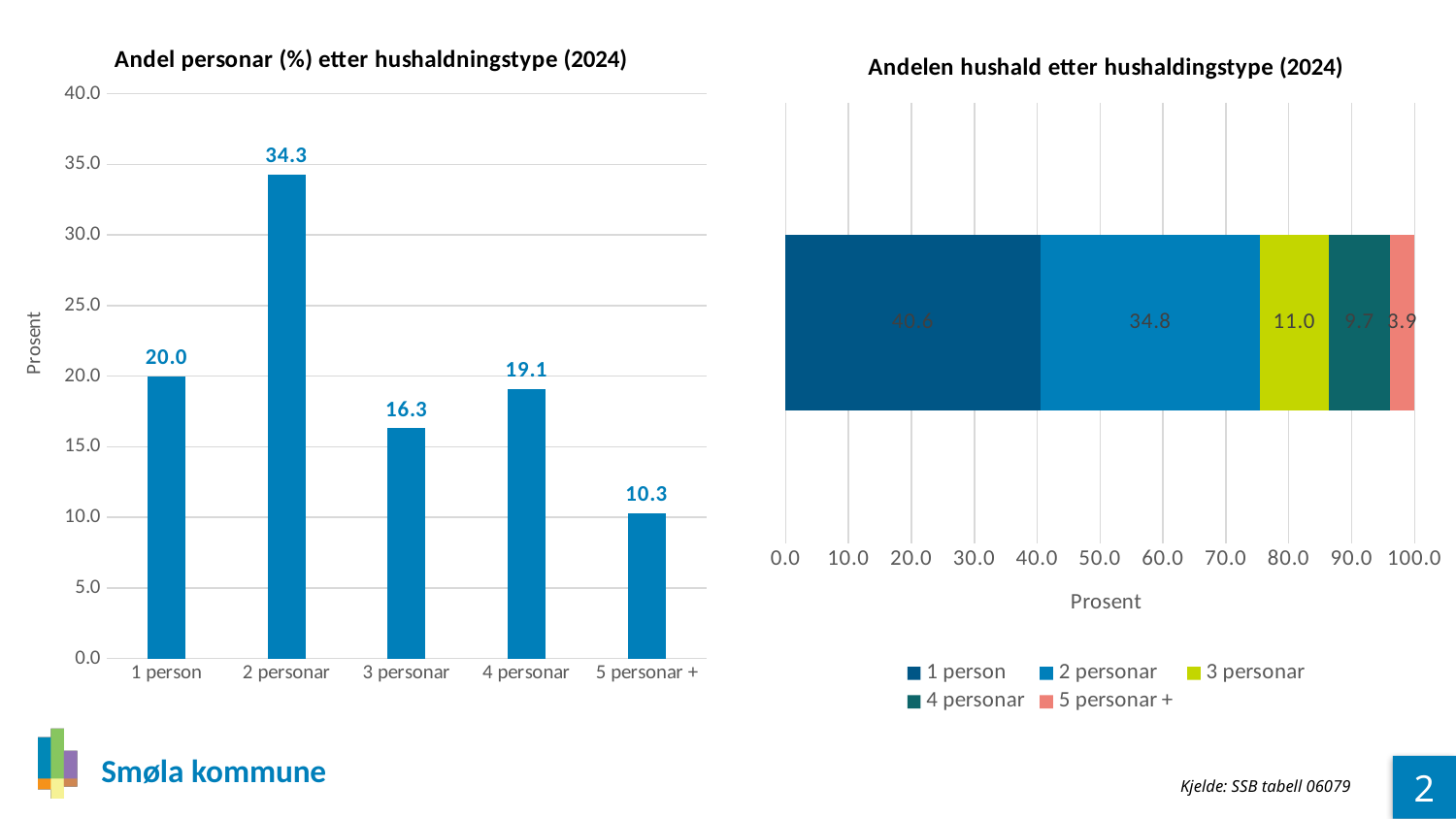
In the chart 'Andel personar (%) etter hushaldningstype (2024)', which is larger: the value for 3 personar or 4 personar? 4 personar In the chart 'Andelen hushald etter hushaldingstype (2024)', what is the value for 3 personar? 11.0 In the chart 'Andel personar (%) etter hushaldningstype (2024)', what is the difference between the values for 2 personar and 1 person? 14.3 In the chart 'Andel personar (%) etter hushaldningstype (2024)', which household type has the lowest value? 5 personar + In the chart 'Andel personar (%) etter hushaldningstype (2024)', which household type has the highest value? 2 personar In the chart 'Andel personar (%) etter hushaldningstype (2024)', what is the value for 5 personar +? 10.3 In the chart 'Andel personar (%) etter hushaldningstype (2024)', what is the value for 2 personar? 34.3 What kind of chart is 'Andel personar (%) etter hushaldningstype (2024)'? Bar chart How many household types are shown in the chart 'Andel personar (%) etter hushaldningstype (2024)'? 5 How many series does the legend list in the chart 'Andelen hushald etter hushaldingstype (2024)'? 5 In the chart 'Andelen hushald etter hushaldingstype (2024)', what is the value for 2 personar? 34.8 In the chart 'Andelen hushald etter hushaldingstype (2024)', is the value for 1 person greater or less than 30.0? greater